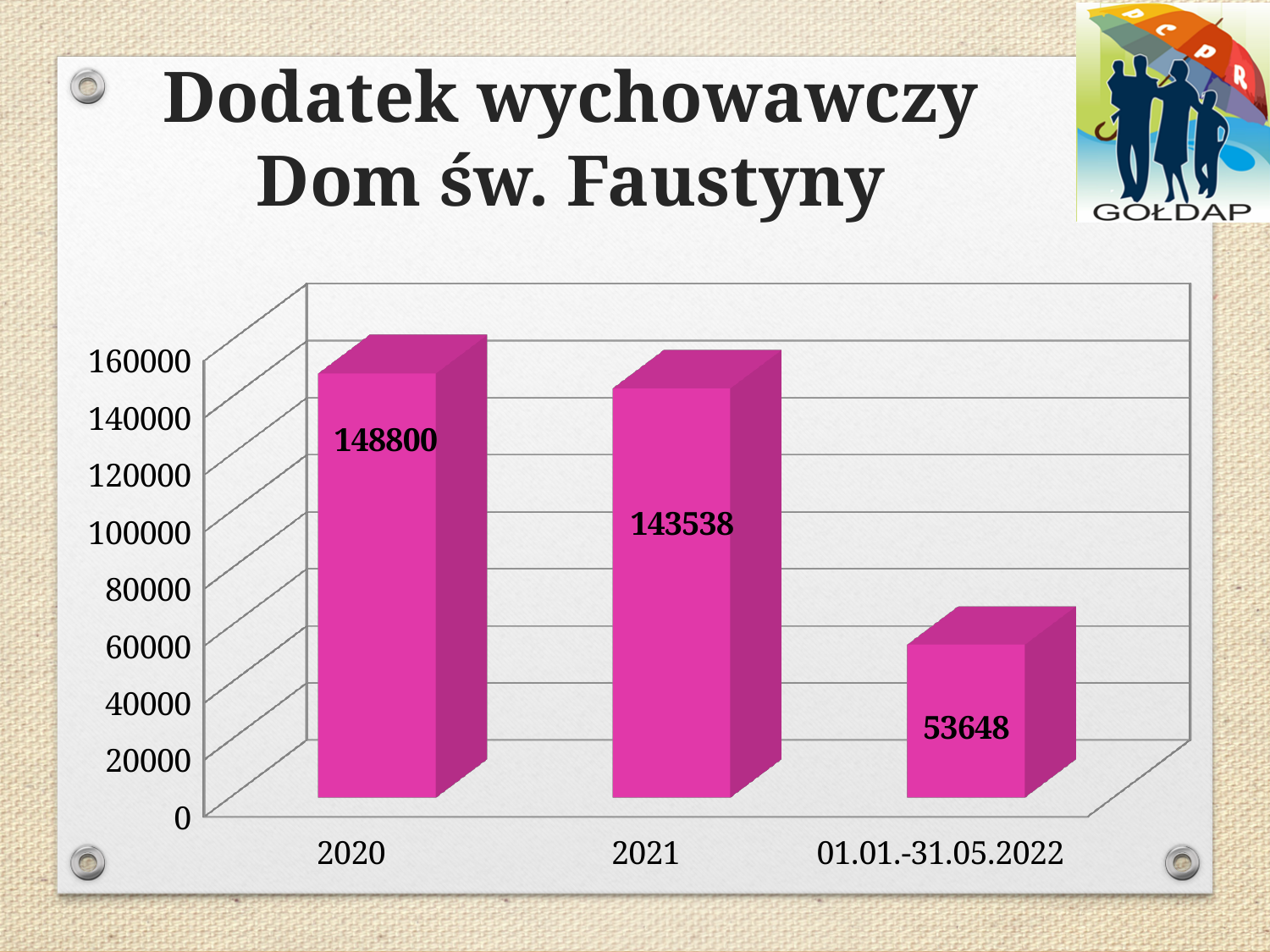
Which is larger, the value for 2020 or the value for 01.01.-31.05.2022? 2020 What is the value for 2020? 148800 Which category has the lowest value? 01.01.-31.05.2022 Do the values rise or fall from left to right along the x axis? fall How many categories are shown on the x axis? 3 What is the difference between the values for 2020 and 2021? 5262 What is the difference between the values for 2021 and 01.01.-31.05.2022? 89890 Which category has the highest value? 2020 What kind of chart is shown on the slide? bar chart What is the value for 2021? 143538 What is the value for 01.01.-31.05.2022? 53648 Is the value for 01.01.-31.05.2022 greater or less than 60000? less